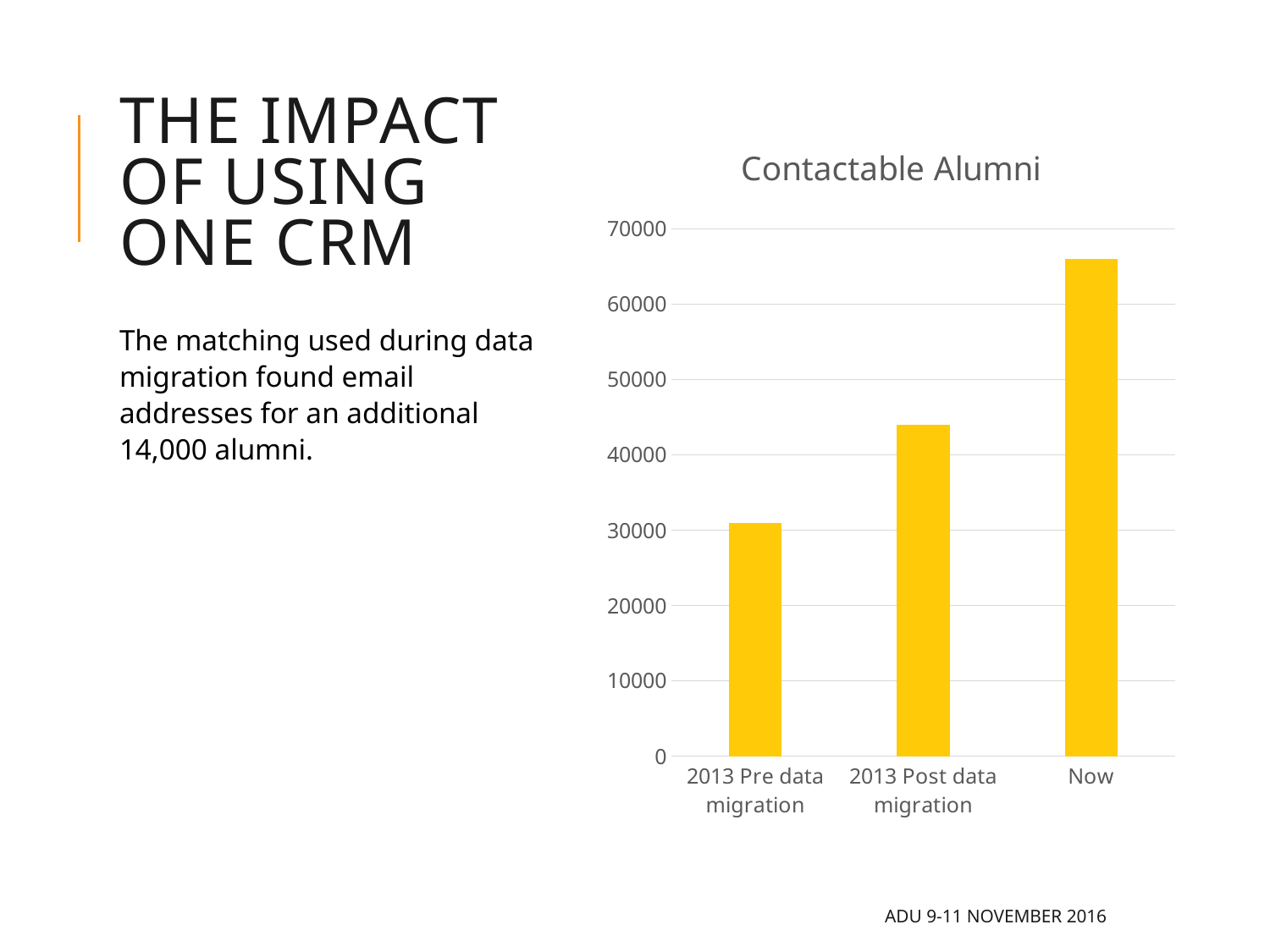
Is the value for 2013 Pre data migration greater or less than 40000? less Do the values rise or fall from left to right across the x axis? rise Which category has the lowest value in the Contactable Alumni chart? 2013 Pre data migration Is the value for 2013 Post data migration greater or less than 40000? greater Is the value for Now greater or less than 60000? greater What type of chart is shown on the slide? bar chart What is the title of the chart? Contactable Alumni Which is larger, the value for 2013 Pre data migration or the value for 2013 Post data migration? 2013 Post data migration How many categories are shown on the x axis of the chart? 3 Which category has the highest value in the Contactable Alumni chart? Now